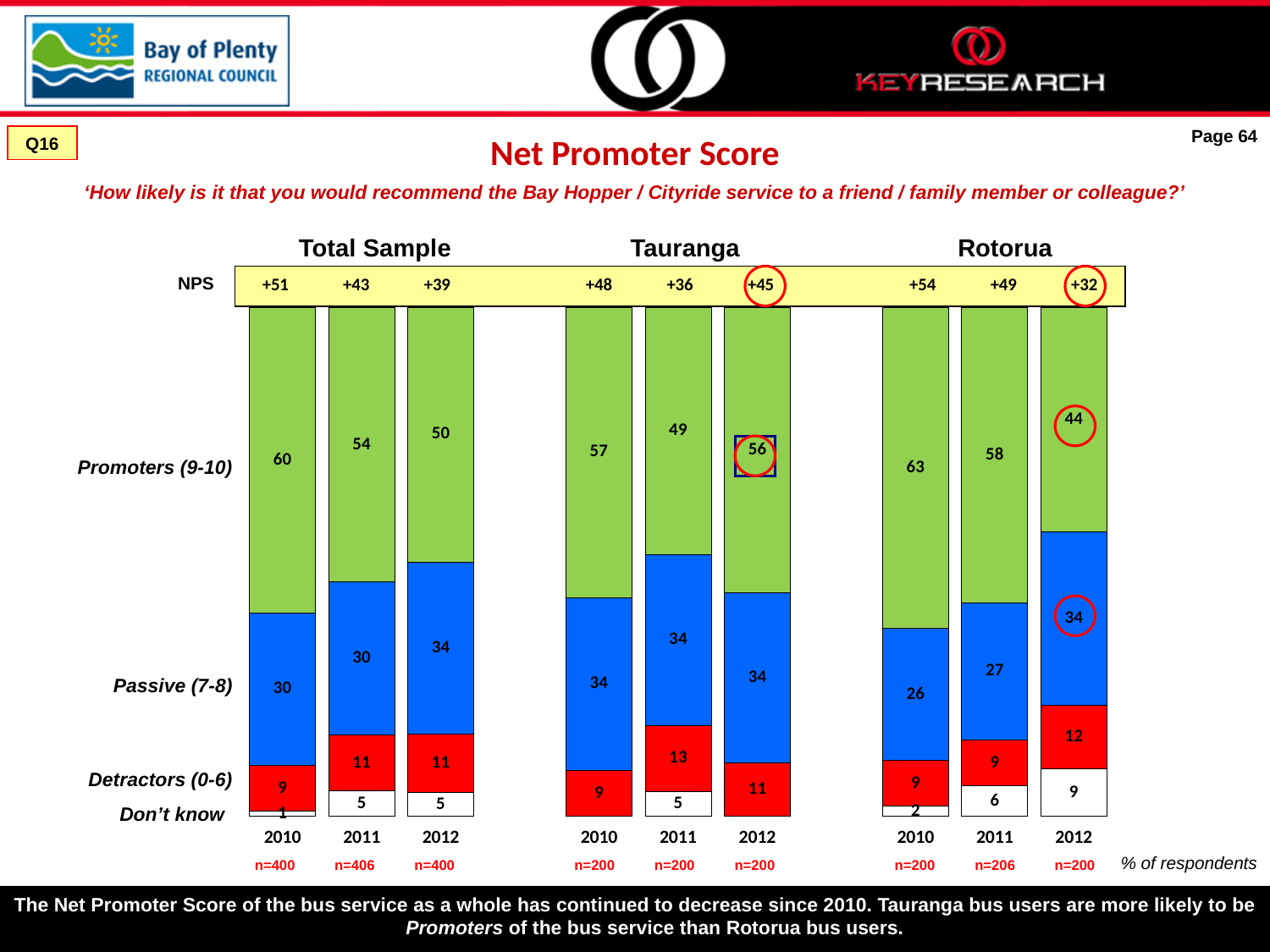
In the Tauranga chart, what is the NPS value shown for 2012? +45 In the Rotorua chart, what percentage of respondents were Passive (7-8) in 2012? 34 In the Rotorua chart, which year has the highest Promoters (9-10) value? 2010 In the Rotorua chart, is the Detractors (0-6) value larger in 2012 or in 2011? 2012 In the Total Sample chart, what is the difference between the Promoters (9-10) values for 2010 and 2012? 10 In the Tauranga chart, which year has the lowest NPS value? 2011 In the Total Sample chart, does the NPS value rise or fall from 2010 to 2012? Fall In the Total Sample chart, what percentage of respondents were Promoters (9-10) in 2010? 60 In the Tauranga chart, what is the Detractors (0-6) value for 2011? 13 How many years are shown on the x axis of the Rotorua chart? 3 In the Rotorua chart, what is the sample size (n) shown for 2011? n=206 What kind of chart is used to show the Total Sample results? Stacked bar chart